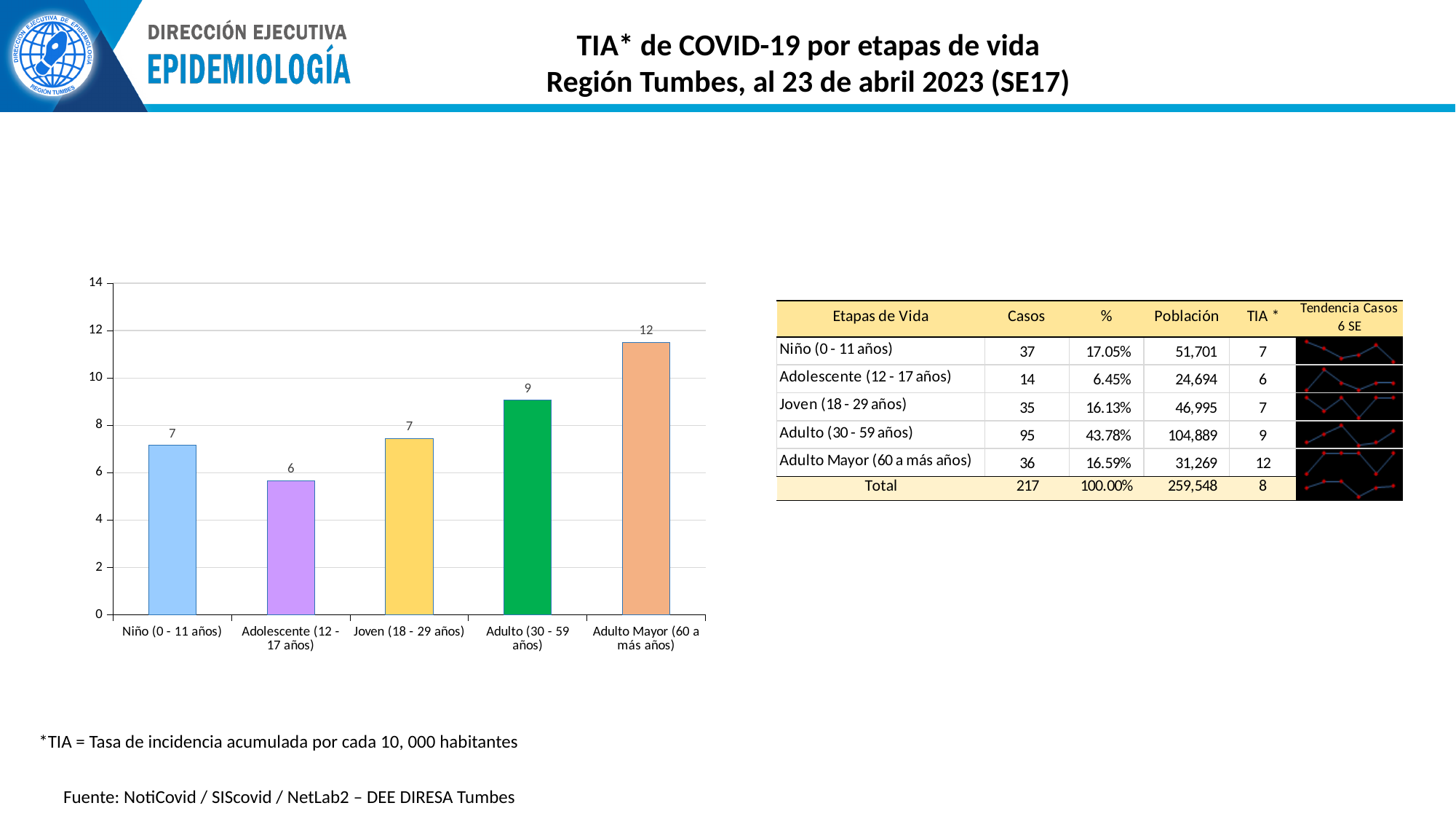
What kind of chart is shown on the slide? bar chart Do the values in the bar chart rise or fall from Joven (18 - 29 años) to Adulto Mayor (60 a más años)? rise Which is larger in the bar chart: the value for Adulto (30 - 59 años) or the value for Joven (18 - 29 años)? Adulto (30 - 59 años) What is the value shown for Adolescente (12 - 17 años) in the bar chart? 6 What is the value shown for Niño (0 - 11 años) in the bar chart? 7 Which category has the highest value in the bar chart? Adulto Mayor (60 a más años) What is the value shown for Adulto Mayor (60 a más años) in the bar chart? 12 What is the value shown for Adulto (30 - 59 años) in the bar chart? 9 Is the value for Adulto Mayor (60 a más años) in the bar chart greater or less than 10? greater What is the difference between the values for Adulto Mayor (60 a más años) and Adulto (30 - 59 años) in the bar chart? 3 Which category has the lowest value in the bar chart? Adolescente (12 - 17 años) How many categories are shown in the bar chart? 5